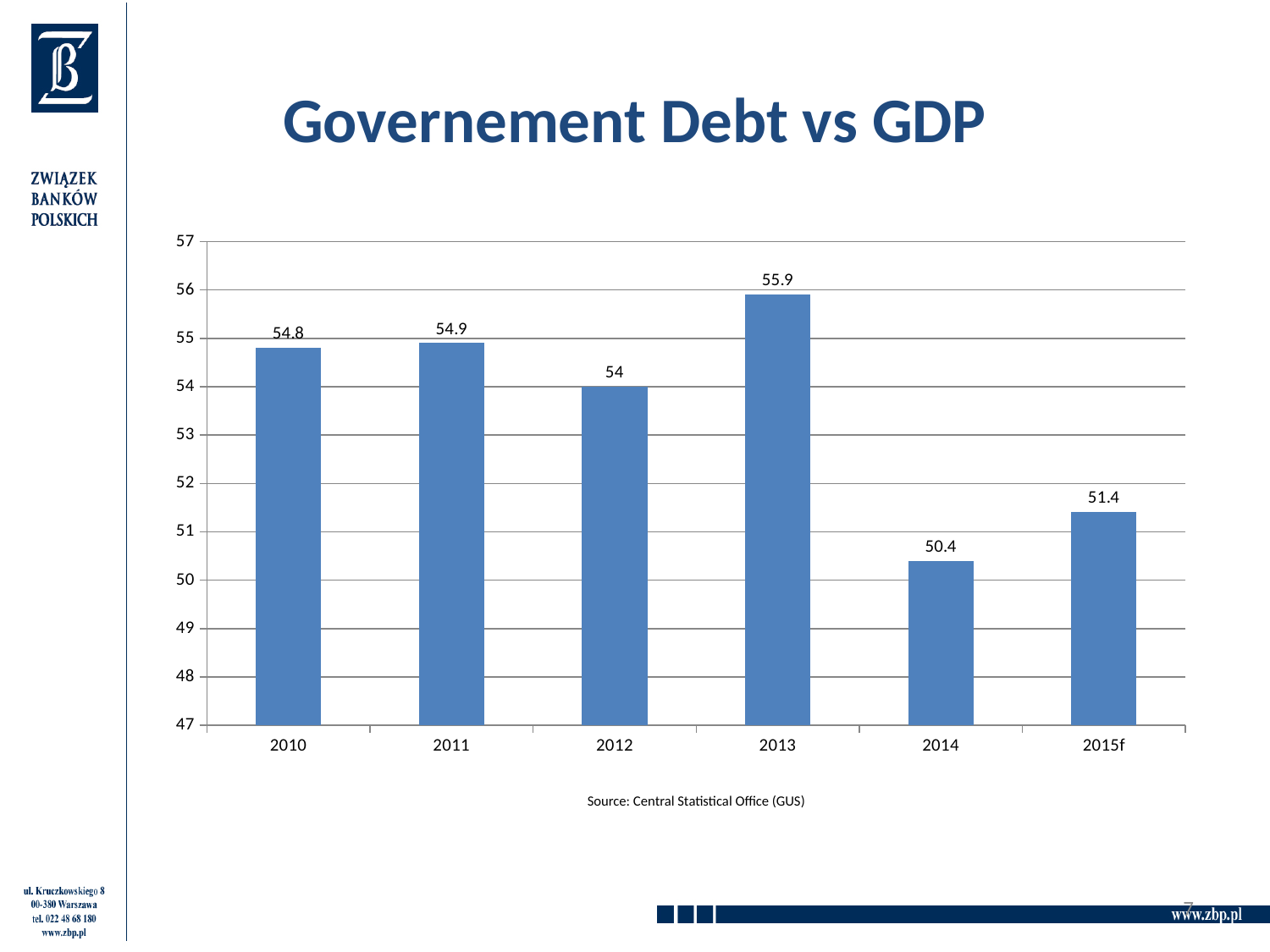
What is the value for 2014? 50.4 What is the title of the slide? Governement Debt vs GDP Which year has the lowest value? 2014 What is the difference between the values for 2010 and 2012? 0.8 What is the difference between the values for 2013 and 2014? 5.5 What is the value for 2015f? 51.4 Which is larger, the value for 2012 or the value for 2015f? 2012 What kind of chart is shown on the slide? bar chart Which year has the highest value? 2013 How many years are shown on the x axis? 6 Is the value for 2011 greater or less than 53? greater What is the value for 2013? 55.9